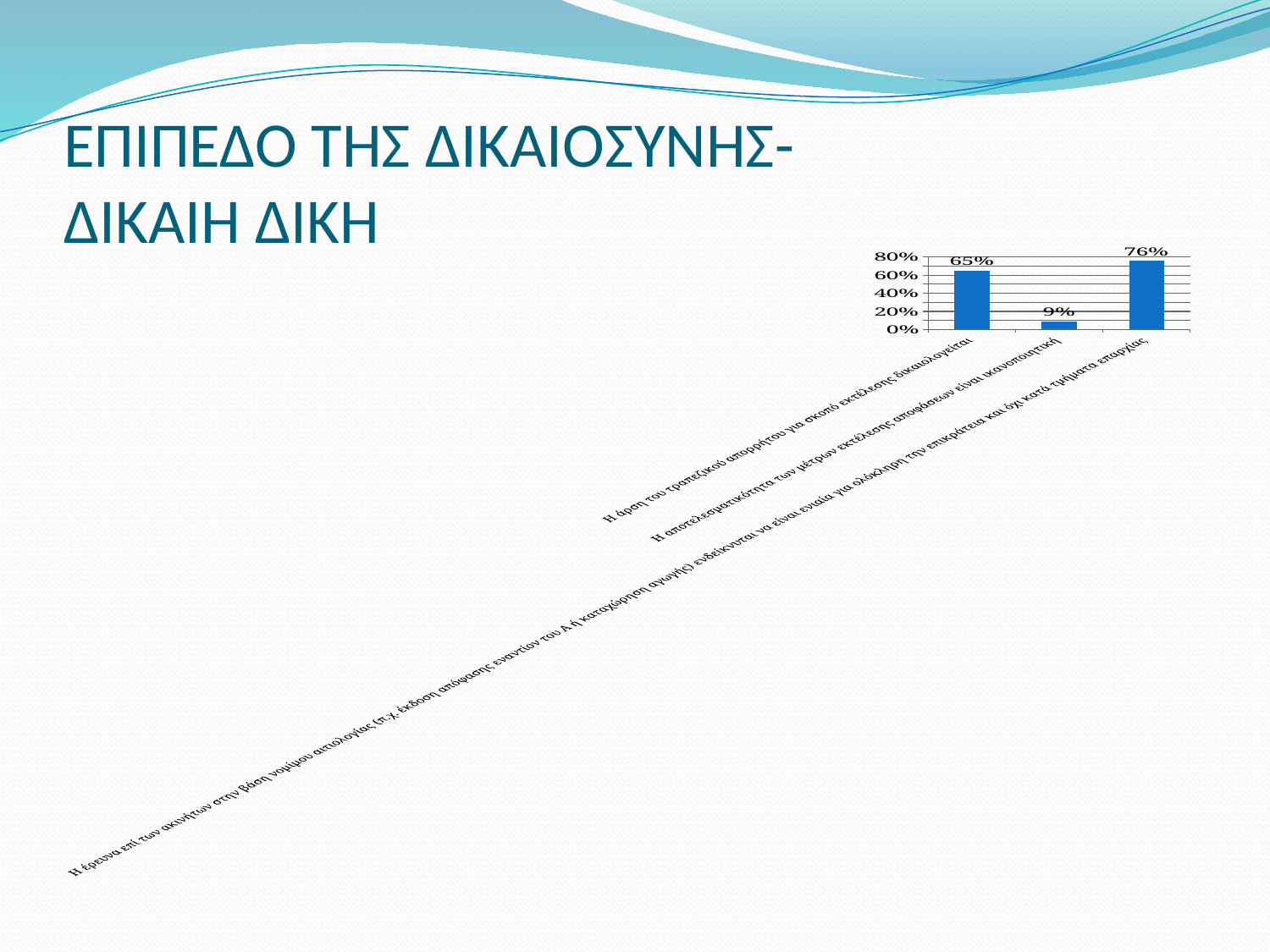
Which is larger, the first bar (Η άρση του τραπεζικού απορρήτου) or the second bar (Η αποτελεσματικότητα των μέτρων εκτέλεσης)? the first bar What is the value of the first bar, for lifting bank secrecy for enforcement purposes (Η άρση του τραπεζικού απορρήτου)? 65% What kind of chart is shown on the slide? bar chart What is the highest value shown on the vertical axis? 80% How many bars (categories) does the chart show? 3 Is the value of the second bar greater or less than 20%? less What is the difference between the third bar (76%) and the first bar (65%)? 11% Which bar has the highest value? the third bar (Η έρευνα επί των ακινήτων), 76% Which bar has the lowest value? the second bar (Η αποτελεσματικότητα των μέτρων εκτέλεσης), 9% What is the value of the third bar, on property searches being uniform across the whole territory (Η έρευνα επί των ακινήτων)? 76% What is the value of the second bar, on the effectiveness of enforcement measures (Η αποτελεσματικότητα των μέτρων εκτέλεσης)? 9% What is the difference between the highest bar (76%) and the lowest bar (9%)? 67%